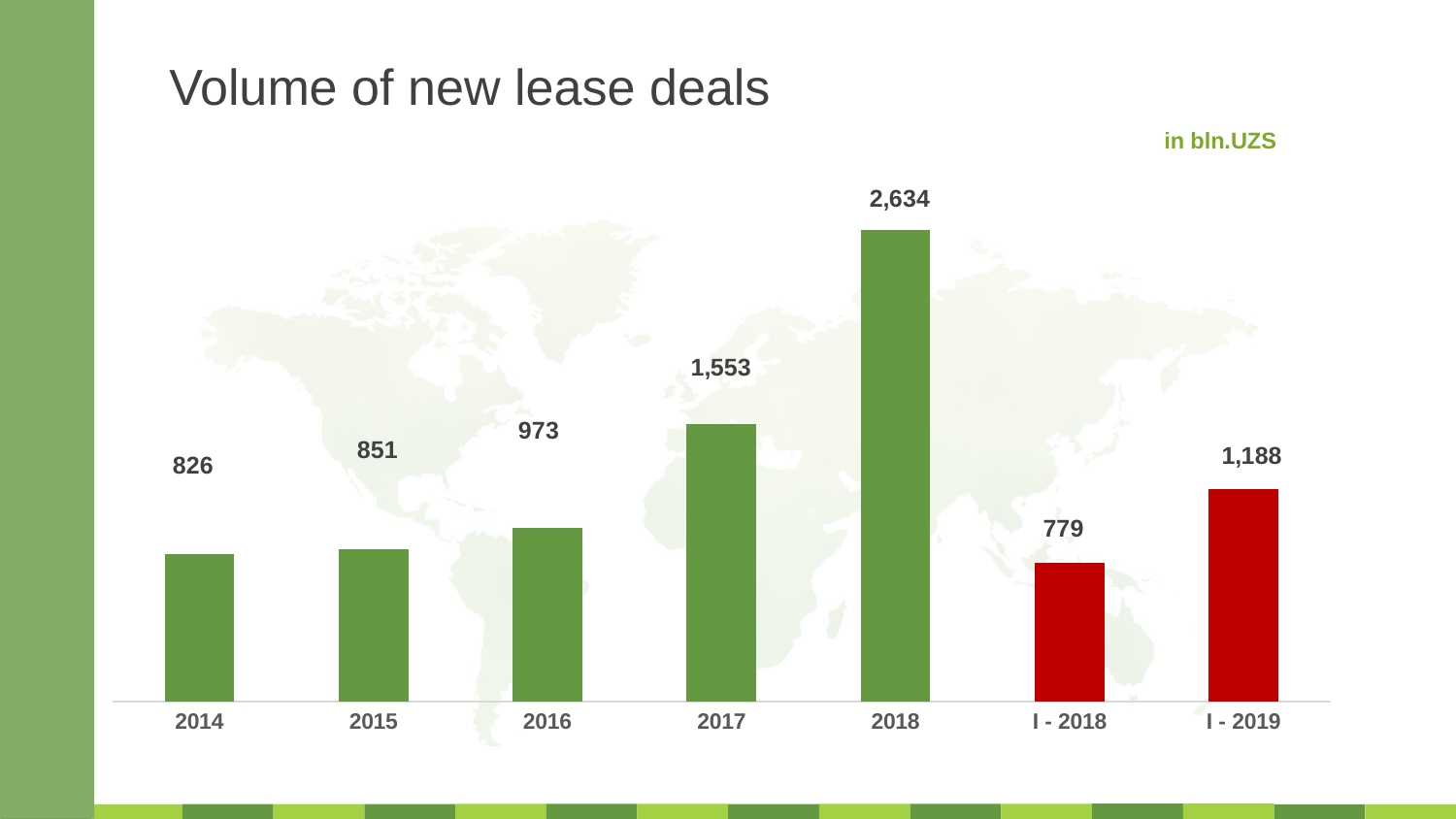
Which category has the lowest value? I - 2018 What is the volume of new lease deals in 2018? 2,634 What is the value shown for 2016? 973 What is the difference between the values for I - 2019 and I - 2018? 409 Do the values rise or fall from 2014 to 2018? rise What unit is stated for the values on the chart? in bln.UZS Which category has the highest value? 2018 Which is larger, the value for 2015 or the value for 2016? 2016 What is the value shown for I - 2019? 1,188 How many categories are shown on the x axis? 7 What kind of chart is shown on the slide? bar chart What is the difference between the values for 2018 and 2017? 1,081